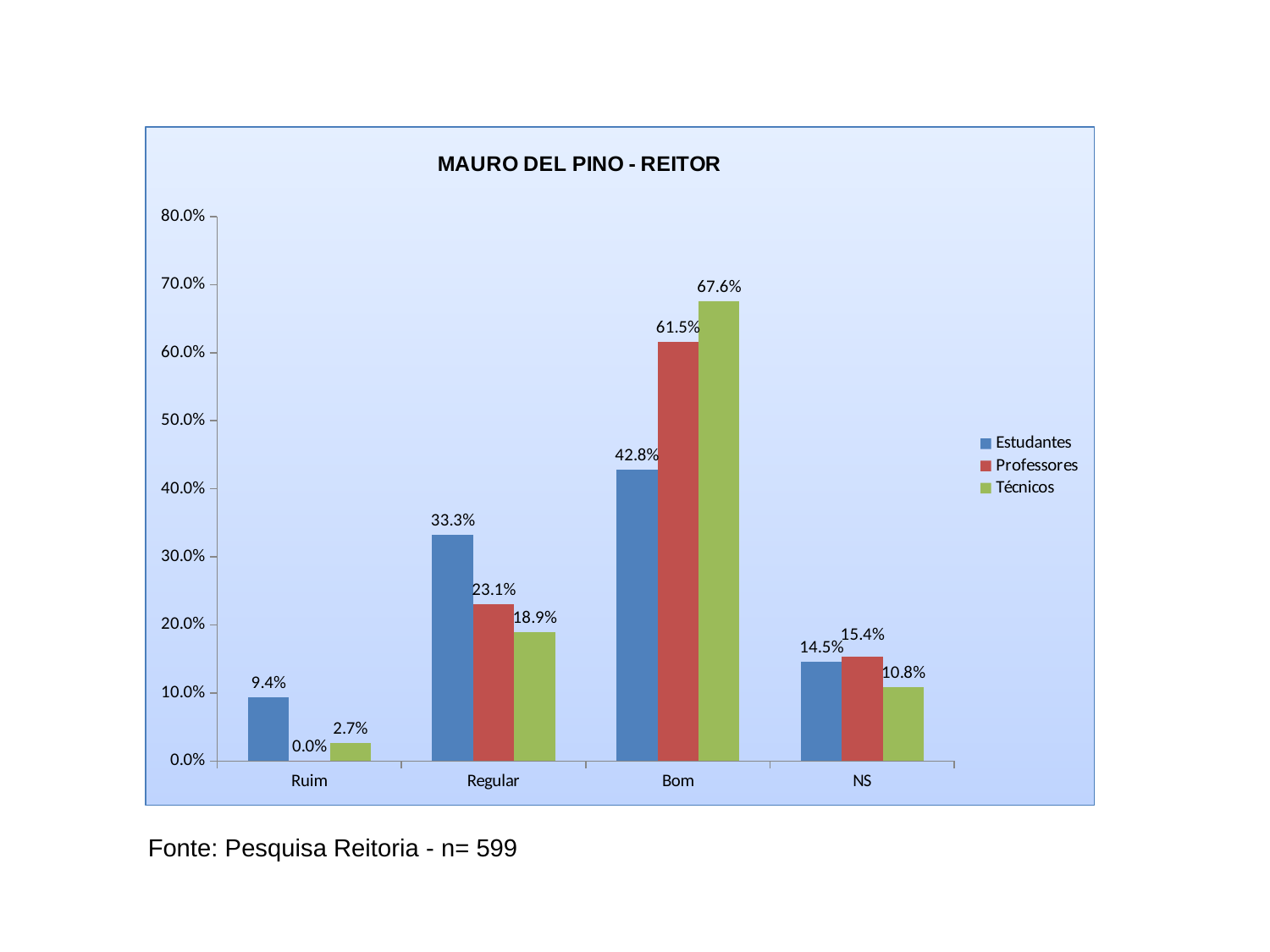
What is the value for Professores in the NS category? 15.4% How many series does the legend list? 3 What is the value for Técnicos in the Ruim category? 2.7% Which is larger in the Regular category: Estudantes or Professores? Estudantes Is the value for Professores in the Bom category greater or less than 60.0%? greater What kind of chart is shown on the slide? Bar chart What is the difference between the Técnicos and Professores values in the Bom category? 6.1% How many categories are shown on the x axis? 4 What is the title of the chart? MAURO DEL PINO - REITOR Which category has the highest value for Técnicos? Bom What is the value for Estudantes in the Bom category? 42.8% Which category has the lowest value for Professores? Ruim